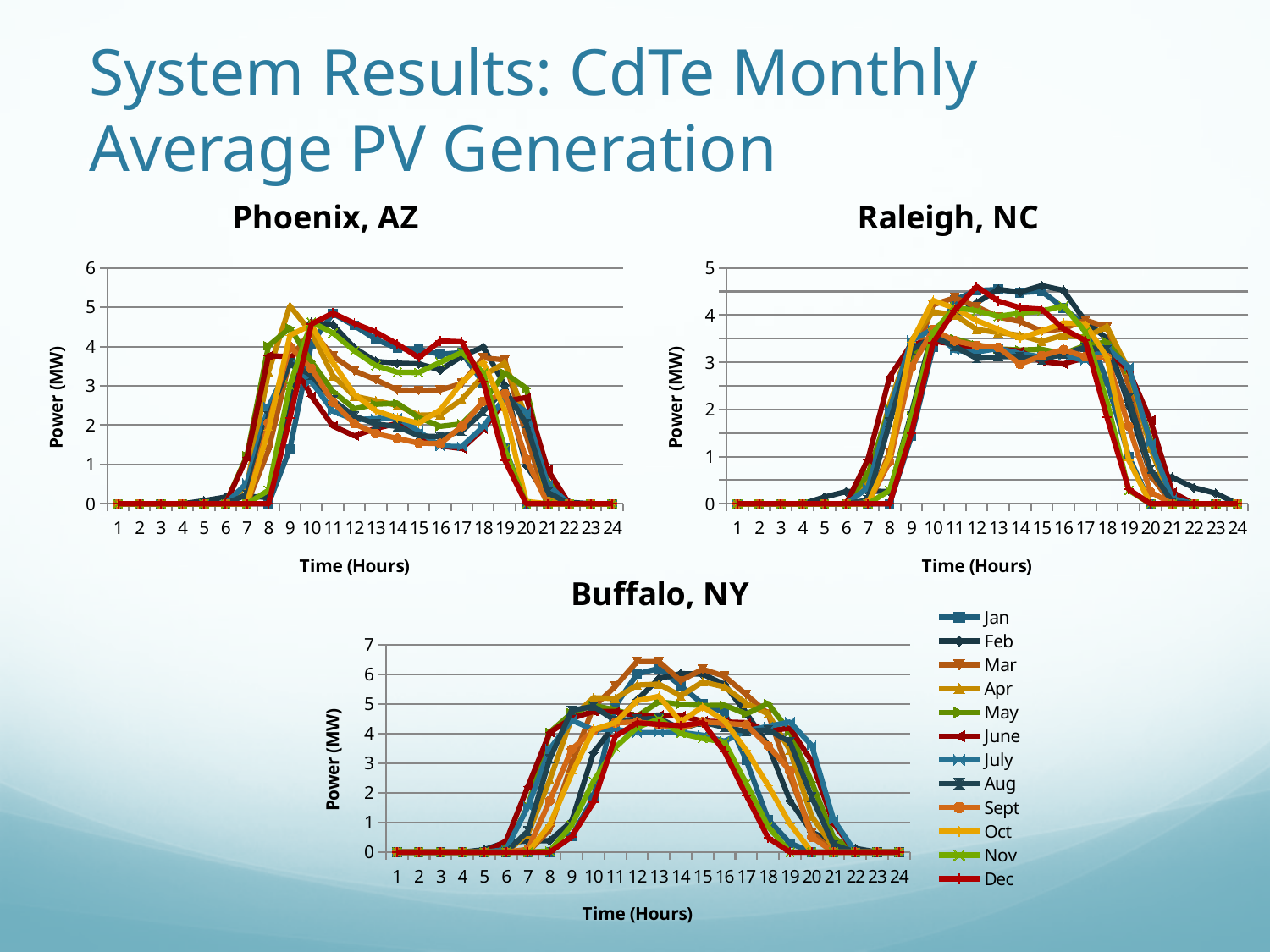
In the Phoenix, AZ chart, is the value for Dec at hour 14 greater or less than 3? greater In the Buffalo, NY chart, is the peak value for Mar around hour 12 greater or less than 6? greater How many hourly points are plotted along the x axis of the Raleigh, NC chart? 24 In the Raleigh, NC chart, what is the value for Dec at hour 24? 0 In the Raleigh, NC chart, is the value for Dec at hour 12 greater or less than 4? greater In the Phoenix, AZ chart, does the Dec series rise or fall from hour 16 to hour 20? fall In the Buffalo, NY chart, does the Dec series rise or fall from hour 8 to hour 12? rise What is the y-axis label on the Raleigh, NC chart? Power (MW) How many series does the legend list for the Buffalo, NY chart? 12 In the Phoenix, AZ chart, what is the value for Jan at hour 1? 0 What kind of chart is the Phoenix, AZ chart? line chart